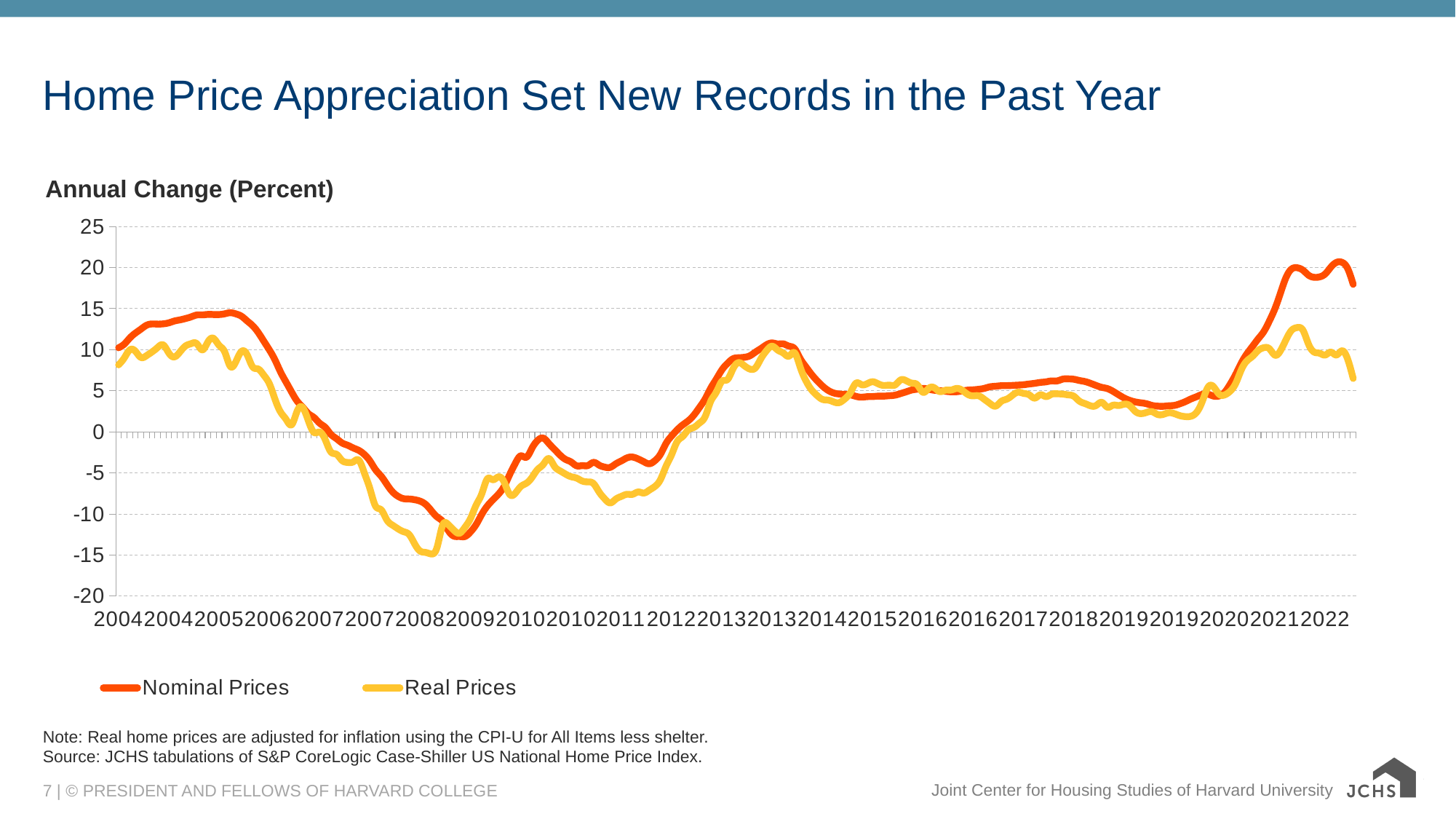
Which series falls to the lowest value anywhere on the chart? Real Prices What are the two series named in the legend? Nominal Prices and Real Prices Which series reaches the highest value anywhere on the chart? Nominal Prices How many series does the legend list? 2 Is the peak value for Nominal Prices around 2021-2022 greater or less than 15? greater Do Nominal Prices rise or fall between 2005 and 2008? fall Do Nominal Prices rise or fall between 2020 and 2021? rise Is the lowest value for Real Prices around 2008-2009 greater or less than -10? less Is the lowest value for Nominal Prices around 2009 greater or less than -10? less What is the label above the chart describing the y-axis measure? Annual Change (Percent) What kind of chart is shown on the slide? line chart At the right end of the chart in 2022, which series is higher, Nominal Prices or Real Prices? Nominal Prices